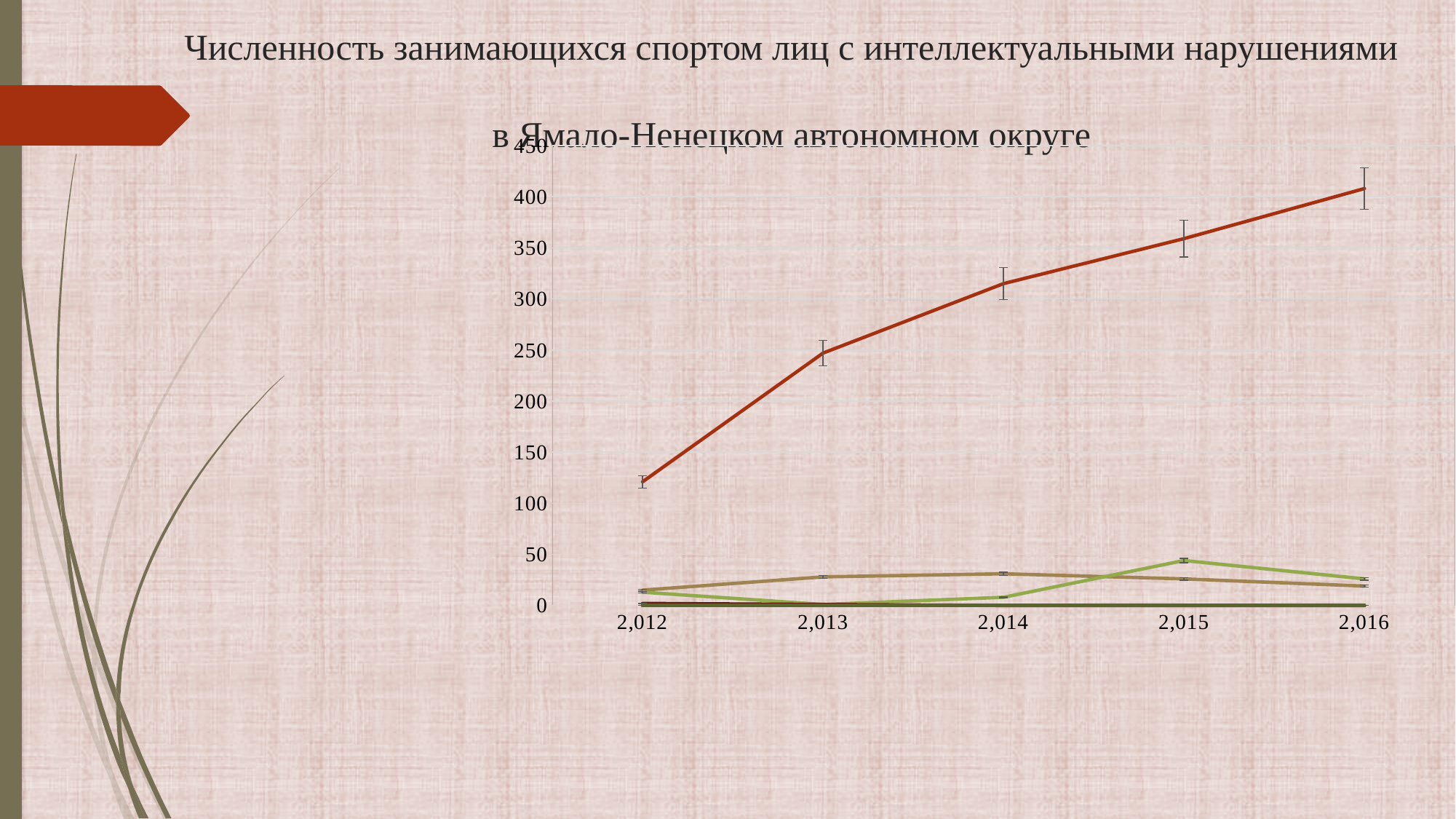
What kind of chart is shown on the slide? line chart In which year does the red line have its lowest value? 2,012 Does the red line rise or fall from 2,012 to 2,016? rises Is the value of the red line in 2,012 greater or less than 150? less What is the last year shown on the x axis? 2,016 Is the value of the red line in 2,012 greater or less than 100? greater Is the value of the red line in 2,014 greater or less than 300? greater How many years are shown on the x axis of the chart? 5 What is the first year shown on the x axis? 2,012 Which is larger for the red line: the value in 2,013 or the value in 2,015? 2,015 In which year does the red line reach its highest value? 2,016